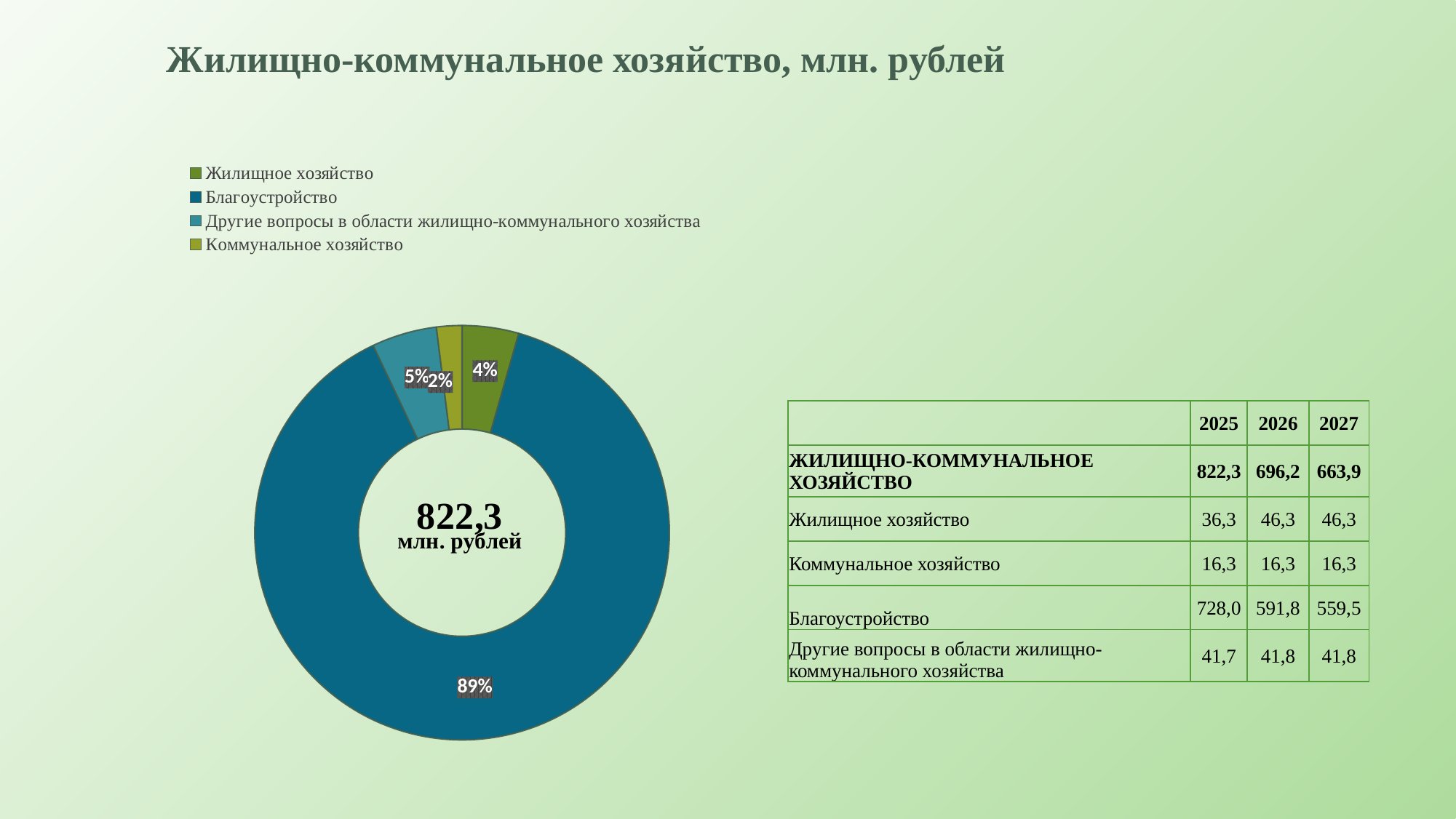
What kind of chart is shown on the slide? doughnut chart Which category has the largest slice in the doughnut chart? Благоустройство How many entries does the legend of the doughnut chart list? 4 Which category has the smallest slice in the doughnut chart? Коммунальное хозяйство What share of the doughnut chart does Коммунальное хозяйство take? 2% What is the title of the slide with the doughnut chart? Жилищно-коммунальное хозяйство, млн. рублей What share of the doughnut chart does Жилищное хозяйство take? 4% What total value is printed in the centre of the doughnut chart? 822,3 млн. рублей How many slices does the doughnut chart have? 4 What share of the doughnut chart does Благоустройство take? 89% Which slice is larger in the doughnut chart: Жилищное хозяйство or Другие вопросы в области жилищно-коммунального хозяйства? Другие вопросы в области жилищно-коммунального хозяйства